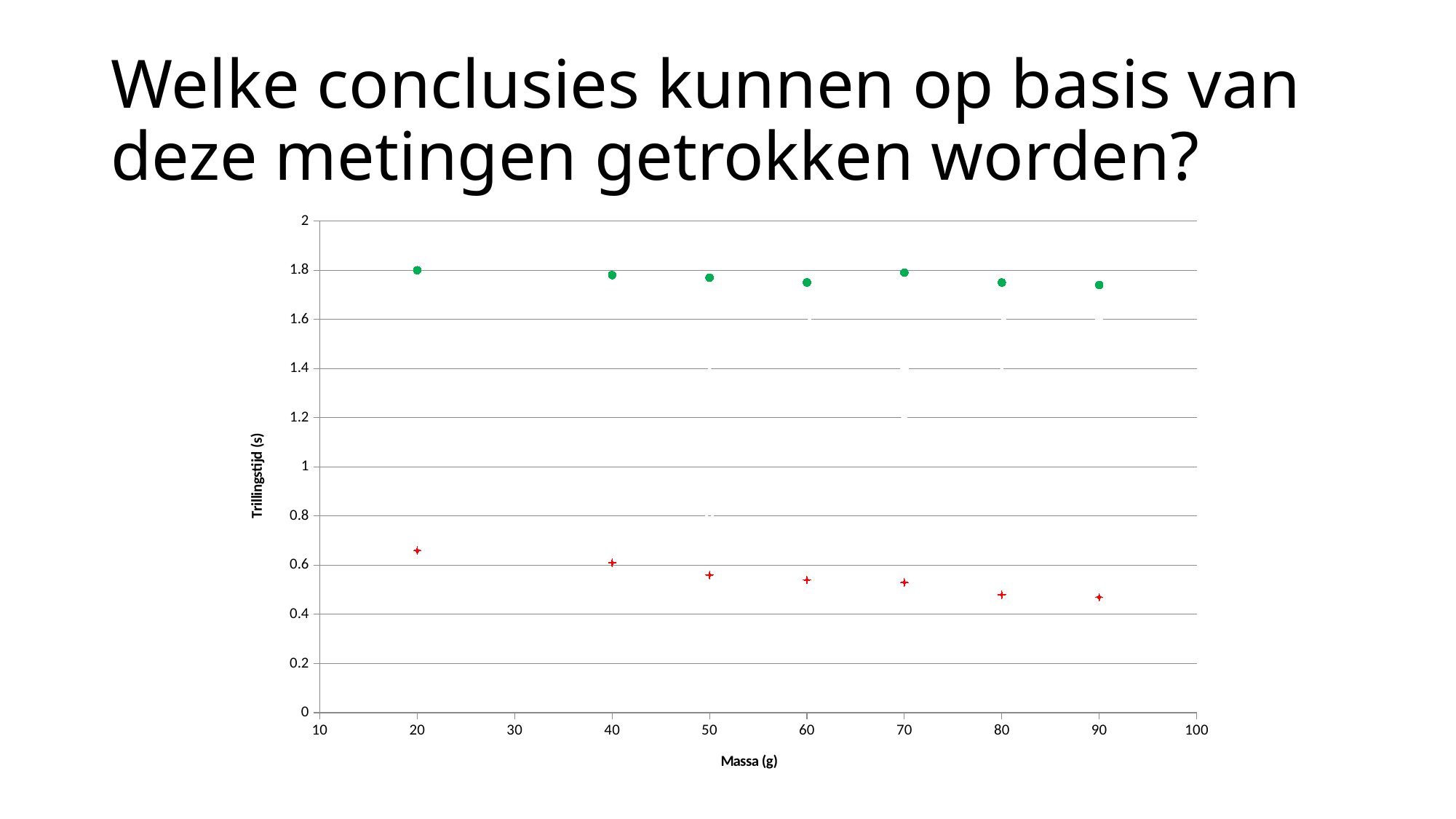
At a mass of 50 g, which series has the larger value, the green series or the red series? the green series How many data points does the red series contain? 7 Is the value of the green series at a mass of 20 g greater or less than 1.6? greater Is the value of the red series at a mass of 90 g greater or less than 0.4? greater What is the title of the x axis? Massa (g) Is the value of the red series at a mass of 20 g greater or less than 0.8? less Do the values of the red series rise or fall as the mass increases? fall At which mass does the red series reach its highest value? 20 g How many data points does the green series contain? 7 What kind of chart is shown on the slide? scatter chart